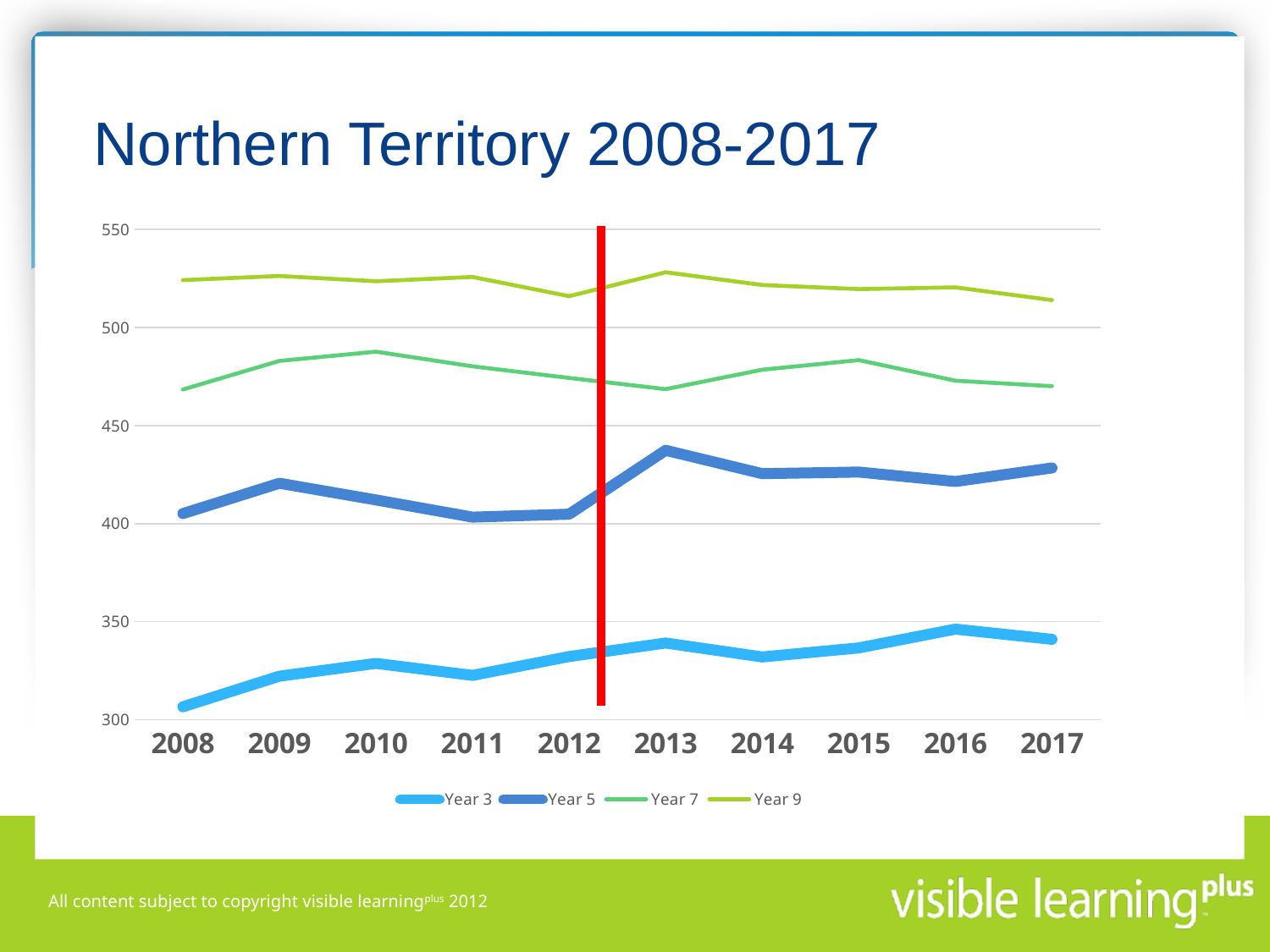
Which is larger in 2017, the value for Year 9 or the value for Year 3? Year 9 Is the value for Year 9 in 2013 greater or less than 500? greater Is the value for Year 3 in 2008 greater or less than 350? less Which series has the highest values across the chart? Year 9 In which year does the Year 3 series reach its highest value? 2016 Is the value for Year 7 in 2008 greater or less than 450? greater How many series does the legend list? 4 How many years are plotted along the x axis? 10 What kind of chart is shown on the slide? Line chart Which series has the lowest values across the chart? Year 3 In which year does the Year 5 series reach its highest value? 2013 What is the title of the chart? Northern Territory 2008-2017